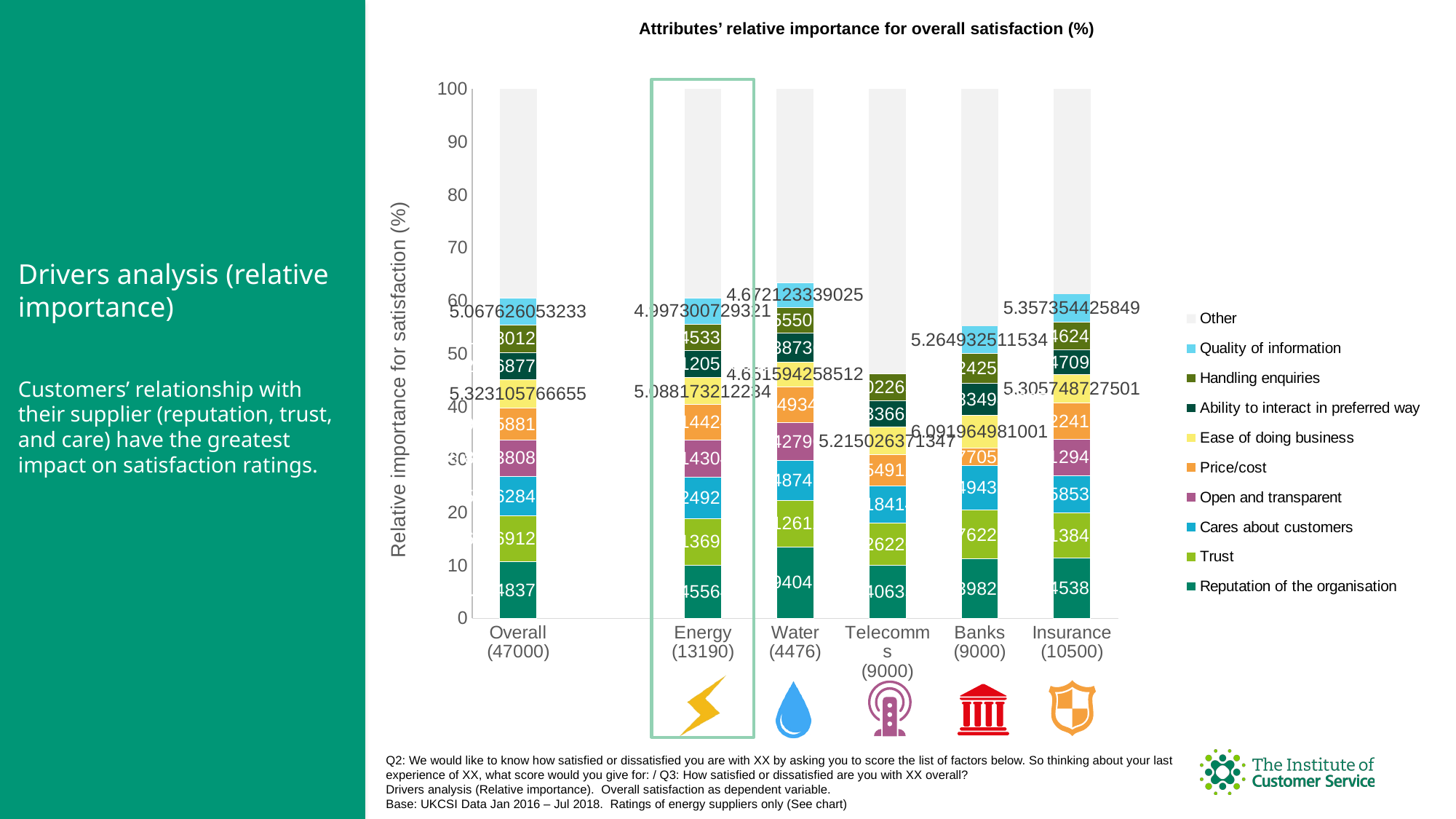
What is the title of the chart? Attributes' relative importance for overall satisfaction (%) Is the 'Reputation of the organisation' value for Water greater or less than 10? greater Which is larger: the 'Reputation of the organisation' segment for Water or for Telecomms? Water How many sector categories are shown along the x axis of the chart? 6 How many series does the chart's legend list? 10 Which category has the largest 'Other' segment? Telecomms What sample size is shown in brackets under the Energy category? 13190 What kind of chart is shown on the slide? Stacked bar chart Is the combined height of the named attribute segments (excluding 'Other') for Telecomms greater or less than 50? less Which category on the x axis is highlighted with a green box? Energy Which category has the smallest 'Other' segment? Water